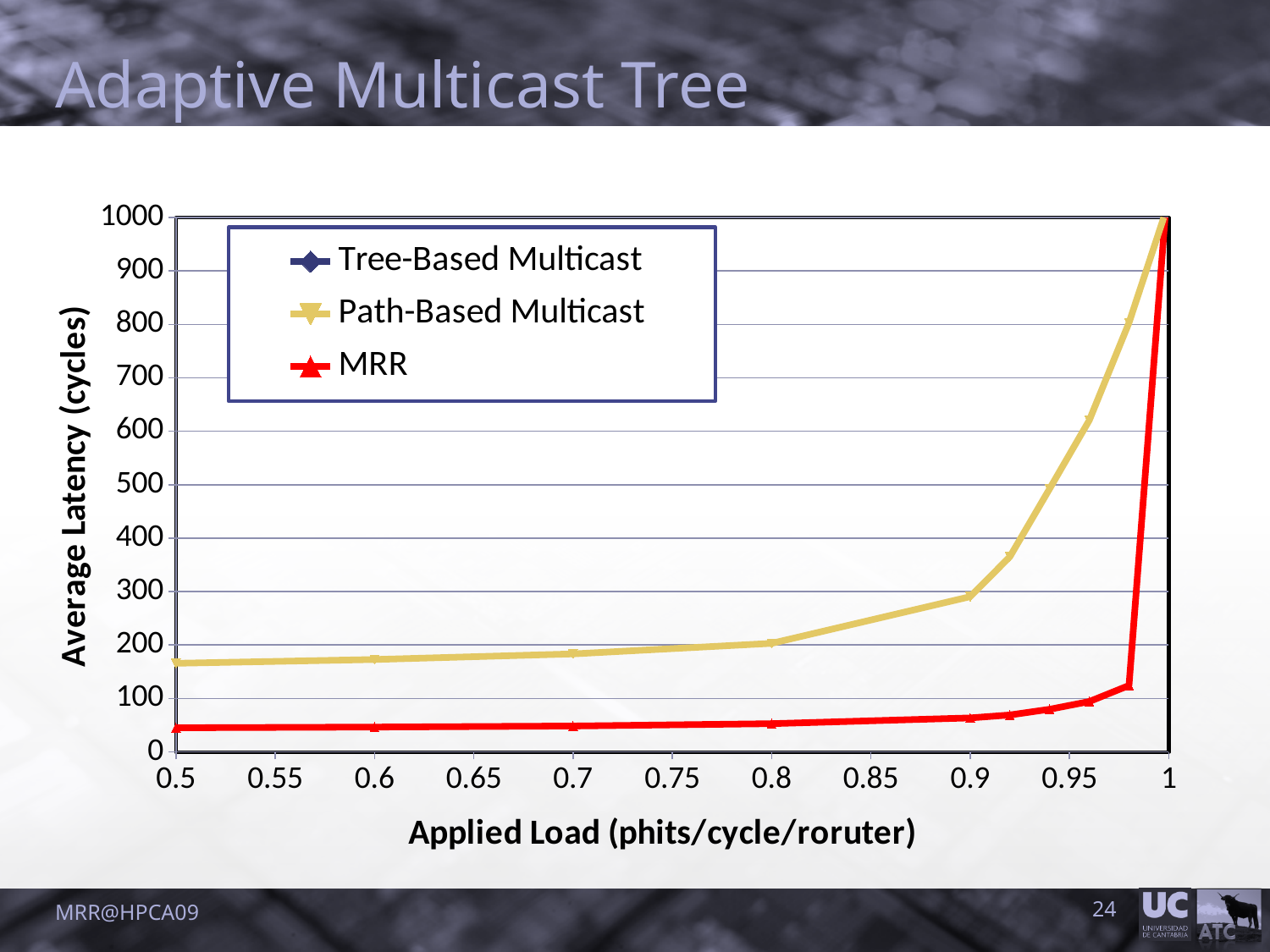
Is the Path-Based Multicast latency at an applied load of 0.5 greater or less than 100? greater Does the Path-Based Multicast latency rise or fall as the applied load increases from 0.5 to 1? rise How many series does the legend list? 3 What is the label of the y axis? Average Latency (cycles) What kind of chart is shown on the slide? line chart At an applied load of 0.9, which has the higher latency, Path-Based Multicast or MRR? Path-Based Multicast How many tick labels are shown on the x axis? 11 Is the Path-Based Multicast latency at an applied load of 0.5 greater or less than 200? less Is the MRR latency at an applied load of 0.5 greater or less than 100? less What is the label of the x axis? Applied Load (phits/cycle/roruter)